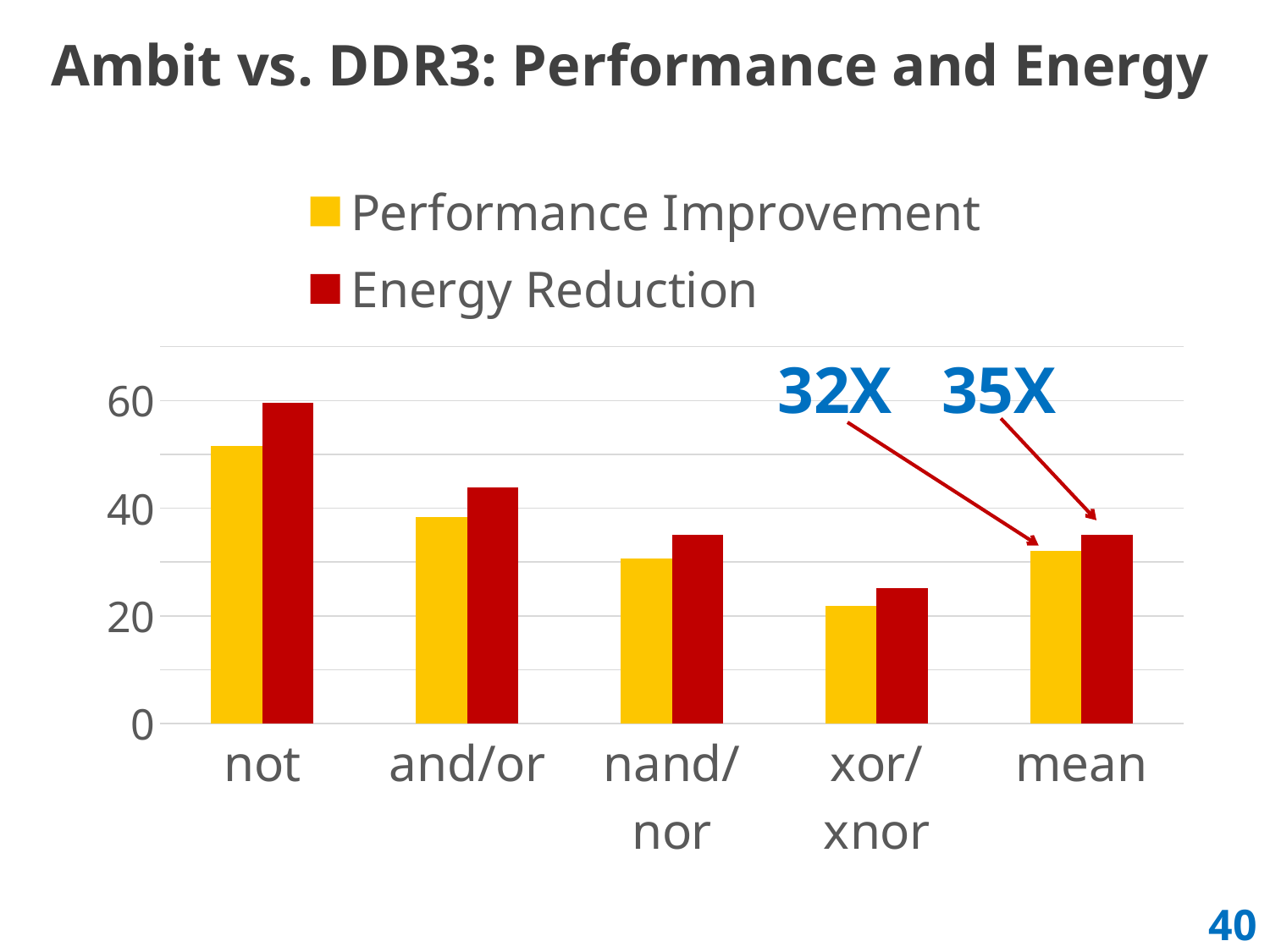
Is the Energy Reduction for xor/xnor greater or less than 40? less What is the difference between the annotated mean Energy Reduction and the annotated mean Performance Improvement? 3X How many categories are shown on the x axis? 5 Do the Performance Improvement values rise or fall from not to xor/xnor along the x axis? fall What kind of chart is shown on the slide? bar chart What is the mean Performance Improvement annotated on the chart? 32X Is the Performance Improvement for not greater or less than 40? greater What is the mean Energy Reduction annotated on the chart? 35X How many series does the legend list? 2 Which operation has the lowest Energy Reduction? xor/xnor For the not operation, which is larger: Performance Improvement or Energy Reduction? Energy Reduction Which operation has the highest Performance Improvement? not